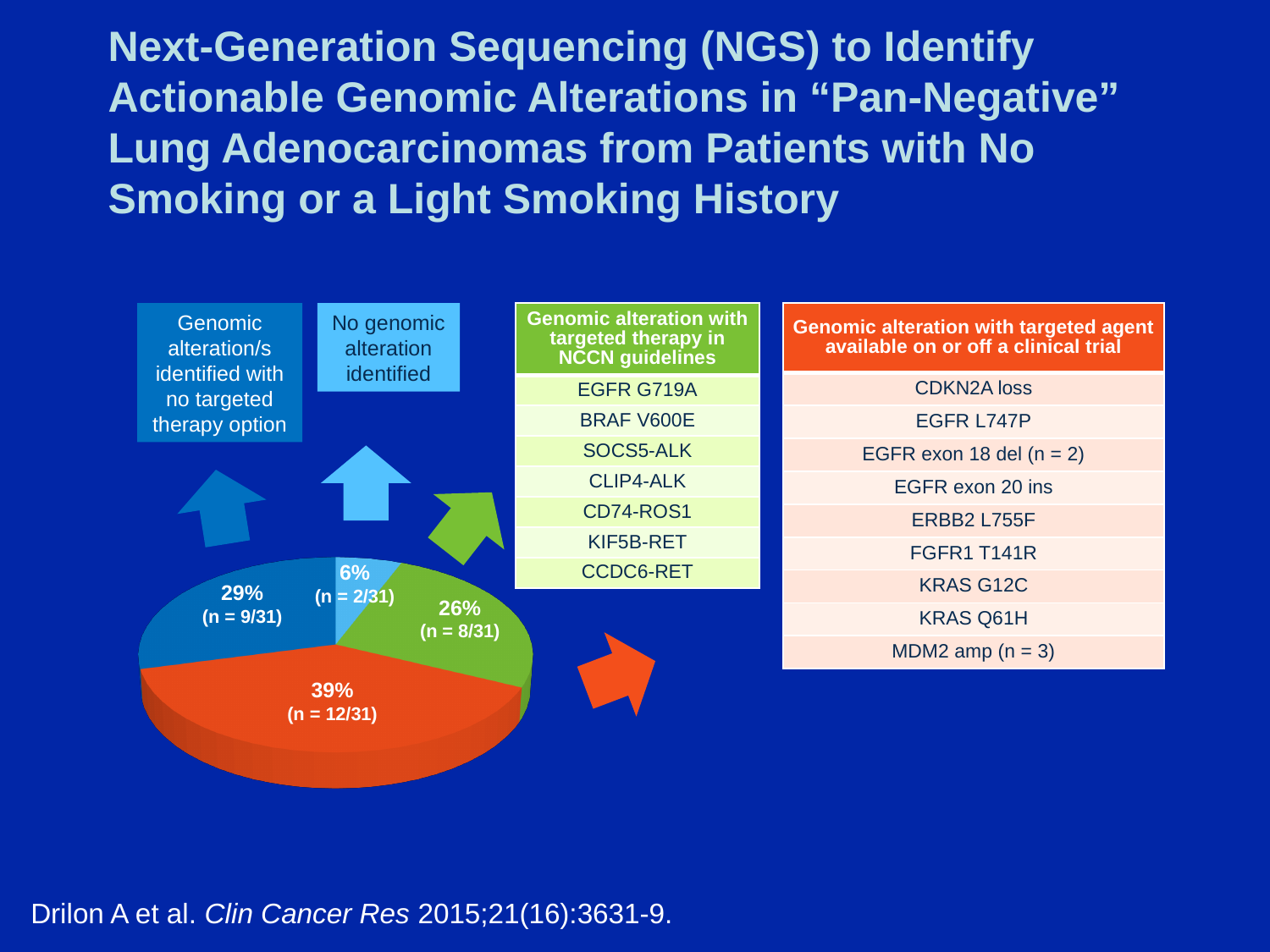
How many patients (n) are in the 39% slice of the pie chart? n = 12/31 What percentage is shown for the dark blue slice of the pie chart (genomic alteration/s identified with no targeted therapy option)? 29% What is the difference in percentage points between the 39% slice and the 26% slice of the pie chart? 13 percentage points Which slice of the pie chart is the smallest? 6% (n = 2/31), no genomic alteration identified What is the total number of patients represented in the pie chart, as shown in the slice labels? 31 What percentage is shown for the orange slice of the pie chart (genomic alteration with targeted agent available on or off a clinical trial)? 39% How many slices does the pie chart have? 4 Which slice of the pie chart is the largest? 39% (n = 12/31), genomic alteration with targeted agent available on or off a clinical trial Which is larger in the pie chart: the slice for genomic alteration/s identified with no targeted therapy option (29%) or the slice for genomic alteration with targeted therapy in NCCN guidelines (26%)? genomic alteration/s identified with no targeted therapy option (29%) What percentage is shown for the light blue slice of the pie chart (no genomic alteration identified)? 6% What type of chart is shown on the slide? pie chart What percentage is shown for the green slice of the pie chart (genomic alteration with targeted therapy in NCCN guidelines)? 26%